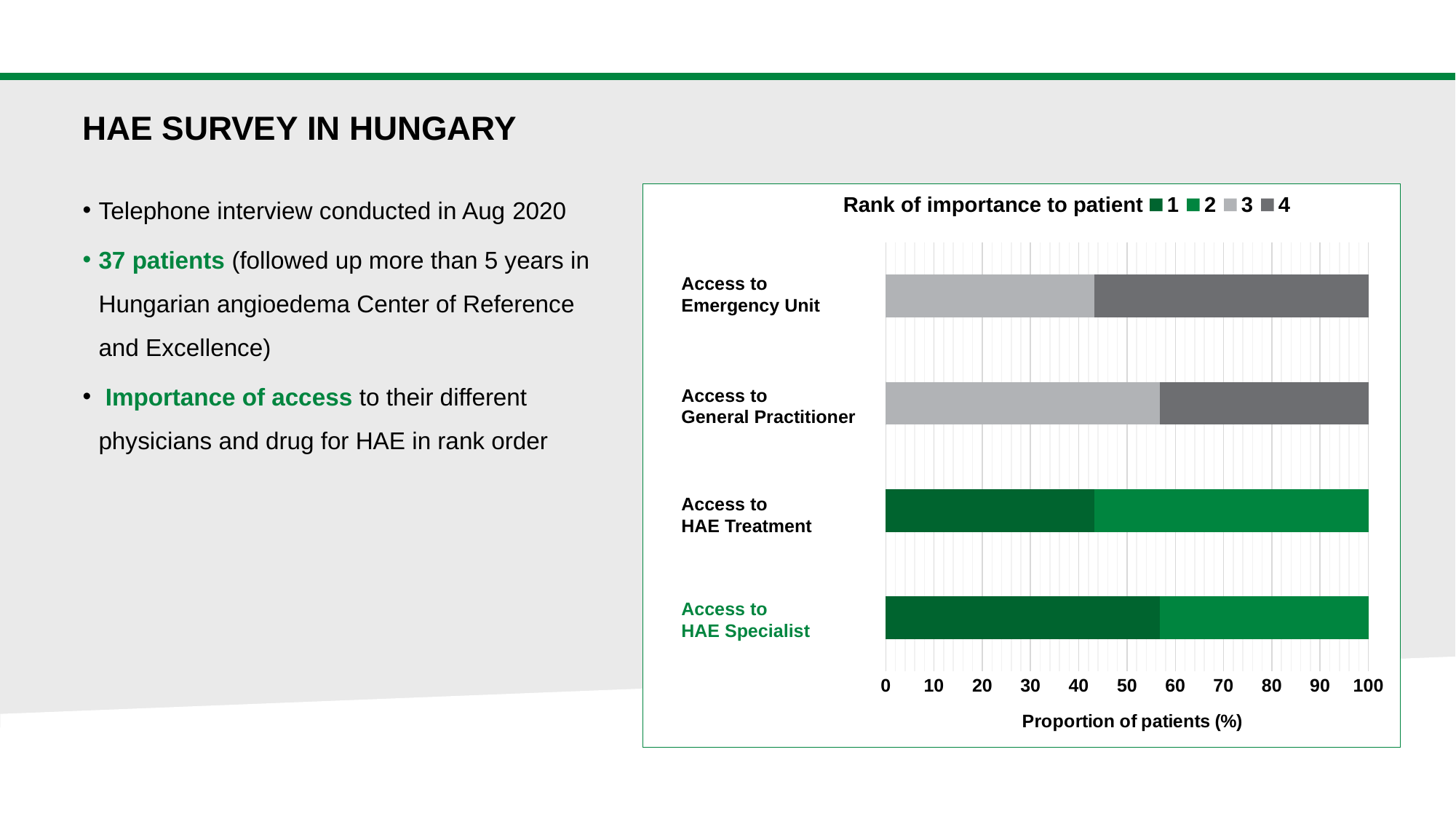
Which has the larger rank 4 segment: Access to Emergency Unit or Access to General Practitioner? Access to Emergency Unit Is the value for rank 3 for Access to Emergency Unit greater or less than 50? less How many series does the chart legend list? 4 Which has the larger rank 1 segment: Access to HAE Specialist or Access to HAE Treatment? Access to HAE Specialist How many categories are plotted on the chart? 4 What is the total of the stacked bar for Access to HAE Specialist? 100 Is the value for rank 1 for Access to HAE Specialist greater or less than 50? greater What is the label of the horizontal axis of the chart? Proportion of patients (%) What is the title of the chart? Rank of importance to patient Is the value for rank 3 for Access to General Practitioner greater or less than 50? greater What kind of chart is shown on the slide? bar chart